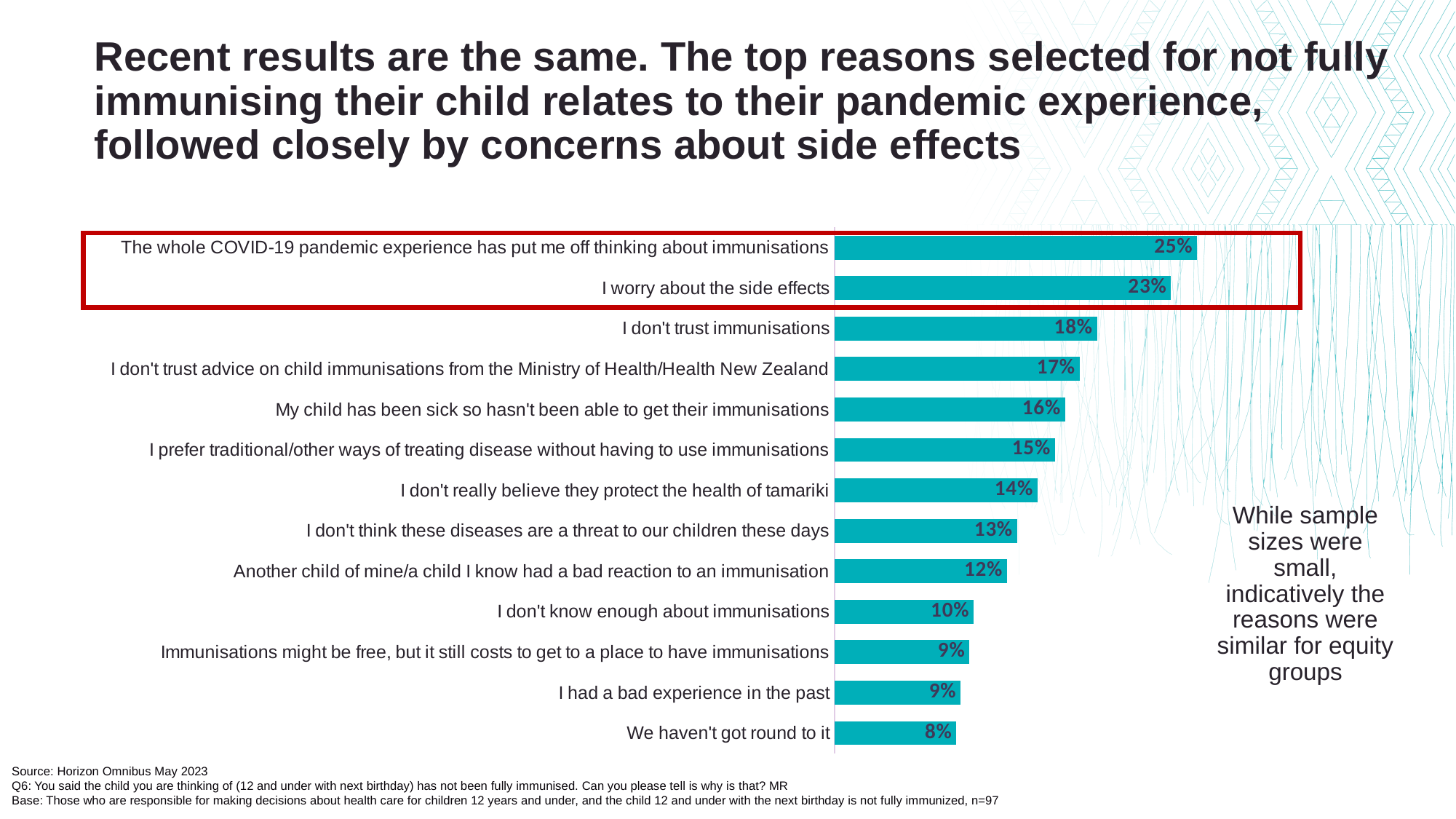
What is the difference between the top reason (25%) and 'We haven't got round to it'? 17% What is the difference between 'I don't trust immunisations' and 'I don't trust advice on child immunisations from the Ministry of Health/Health New Zealand'? 1% Which reason has the highest percentage? The whole COVID-19 pandemic experience has put me off thinking about immunisations How many reasons are enclosed by the red box on the chart? 2 Which reason has the lowest percentage? We haven't got round to it What kind of chart is shown on the slide? Bar chart What percentage selected 'The whole COVID-19 pandemic experience has put me off thinking about immunisations'? 25% What percentage is shown for 'I don't know enough about immunisations'? 10% Which is larger: 'My child has been sick so hasn't been able to get their immunisations' or 'I don't really believe they protect the health of tamariki'? My child has been sick so hasn't been able to get their immunisations What is the value for 'I worry about the side effects'? 23% How many reasons are plotted in the chart? 13 What is the value for 'Another child of mine/a child I know had a bad reaction to an immunisation'? 12%